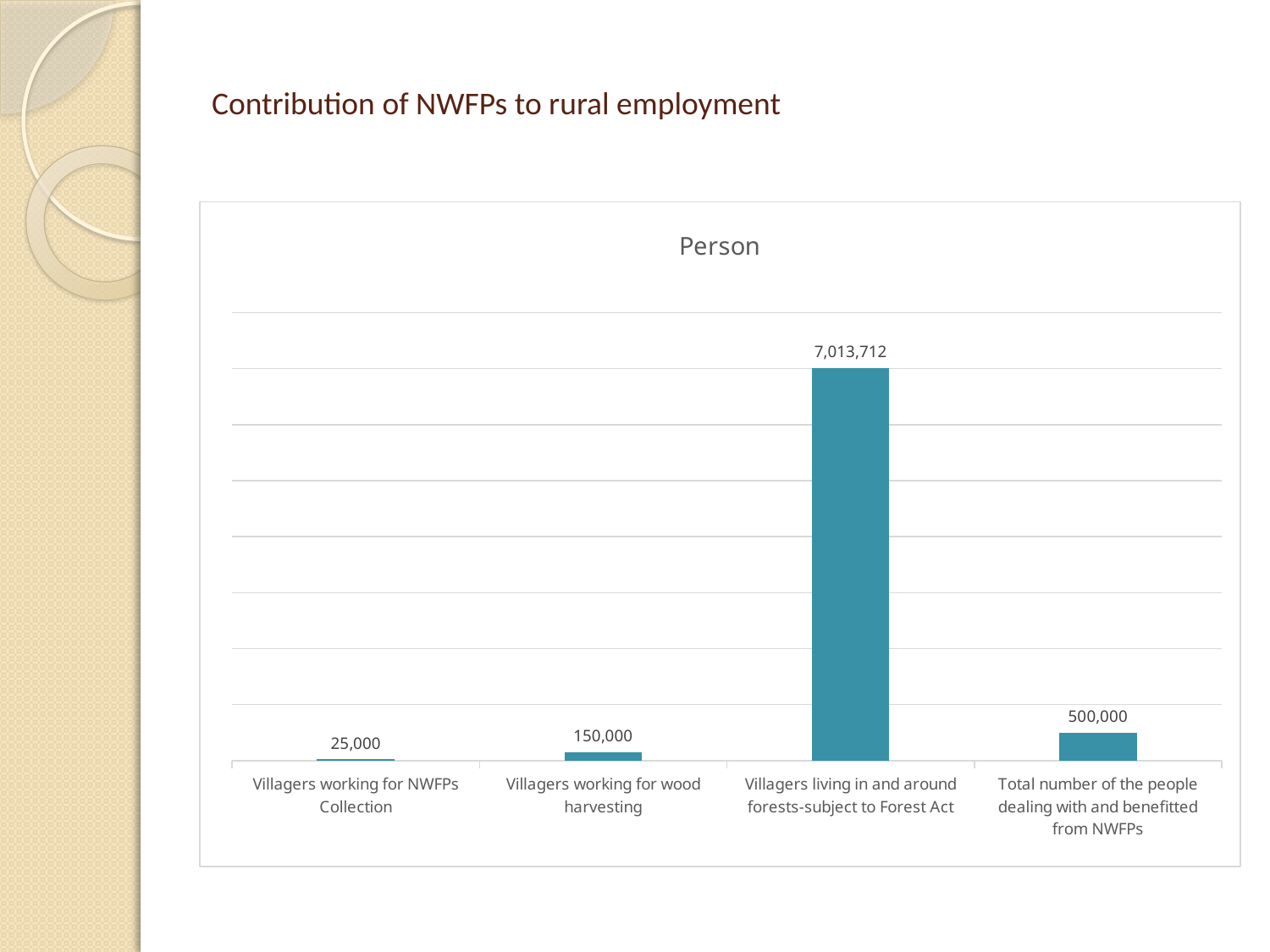
What is the value for Villagers living in and around forests-subject to Forest Act? 7,013,712 Which category has the highest value? Villagers living in and around forests-subject to Forest Act What is the value for Total number of the people dealing with and benefitted from NWFPs? 500,000 What is the value for Villagers working for wood harvesting? 150,000 What is the value for Villagers working for NWFPs Collection? 25,000 What kind of chart is shown on the slide? Bar chart Which category has the lowest value? Villagers working for NWFPs Collection What is the difference between the values for Total number of the people dealing with and benefitted from NWFPs and Villagers working for wood harvesting? 350,000 What is the difference between the values for Villagers working for wood harvesting and Villagers working for NWFPs Collection? 125,000 Which is larger: the value for Villagers working for wood harvesting or the value for Total number of the people dealing with and benefitted from NWFPs? Total number of the people dealing with and benefitted from NWFPs How many categories are shown in the chart? 4 What is the title of the chart? Person